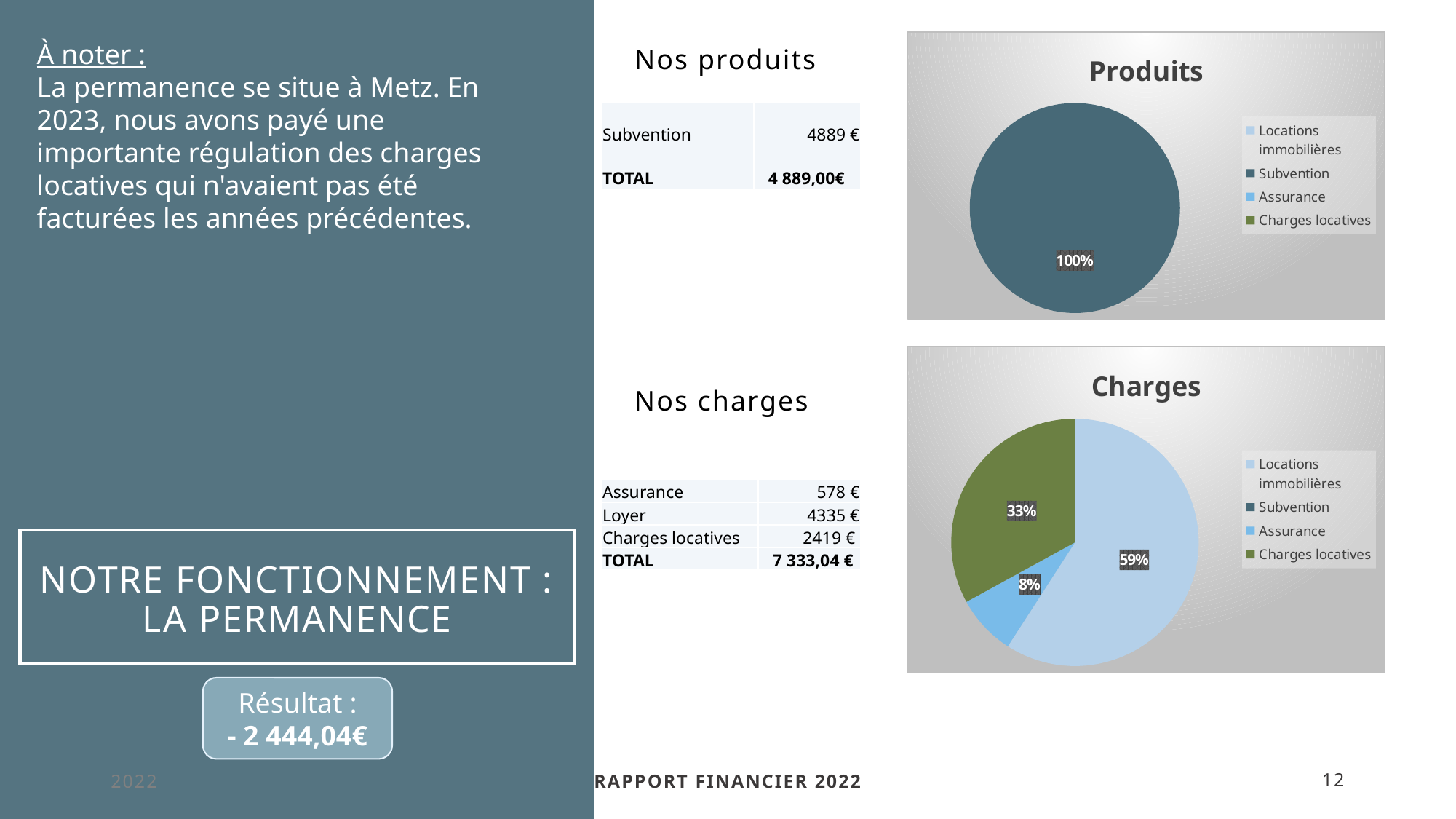
What kind of chart is the "Produits" chart? pie chart In the "Produits" chart, what share is shown on the single slice? 100% In the "Charges" chart, which category has the smallest visible slice? Assurance In the "Produits" chart, which legend category does the only slice correspond to? Subvention In the "Charges" chart, what share does the Assurance slice have? 8% In the "Charges" chart, what is the difference in percentage points between the Locations immobilières slice and the Charges locatives slice? 26 What kind of chart is the "Charges" chart? pie chart How many entries does the legend of the "Charges" chart list? 4 In the "Charges" chart, which category has the largest slice? Locations immobilières In the "Charges" chart, what share does the Charges locatives slice have? 33% In the "Charges" chart, which is larger: the Charges locatives slice or the Assurance slice? Charges locatives